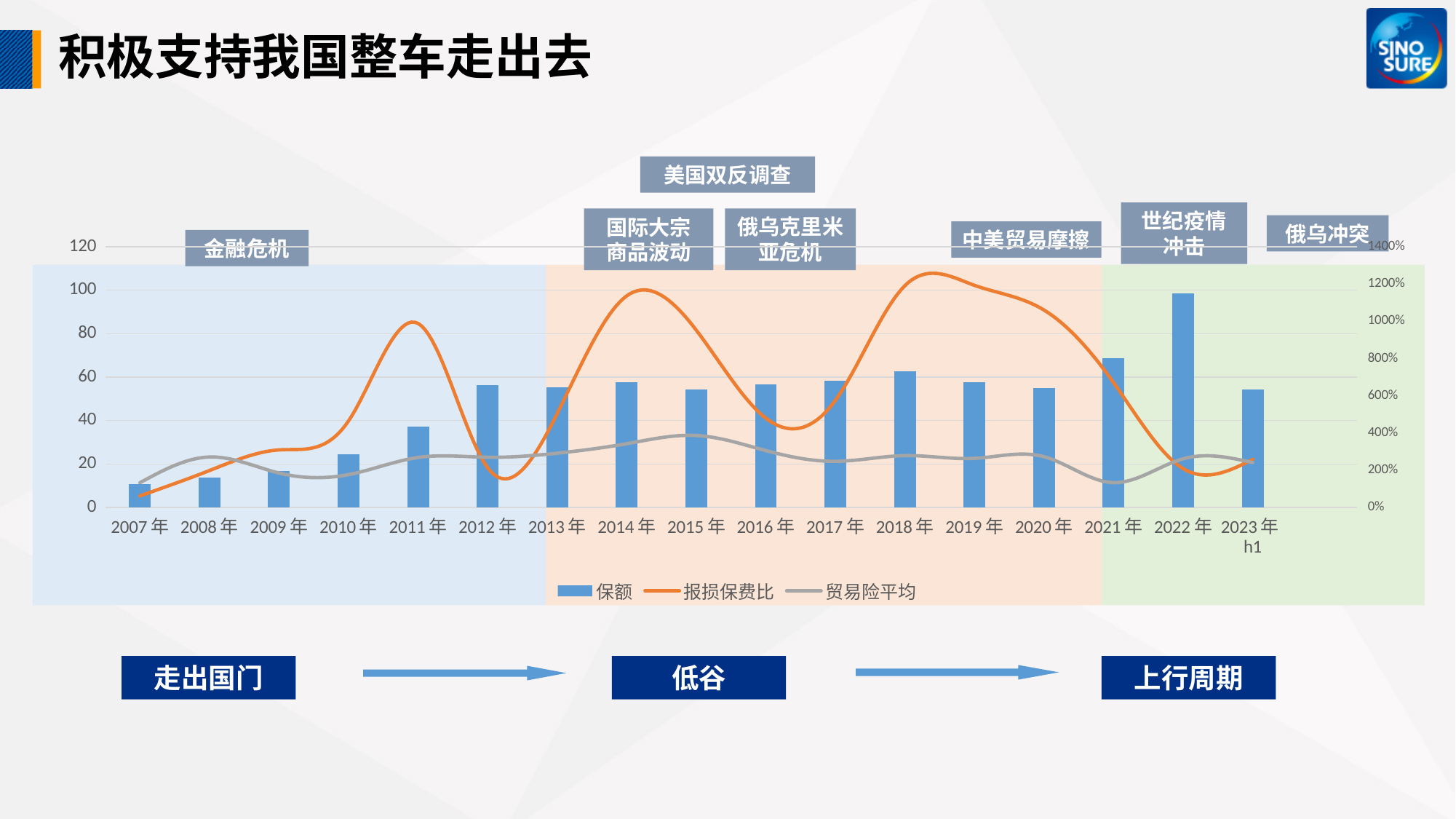
How many year categories are shown on the x axis of the chart? 17 What kind of chart is shown on the slide? A combined bar and line chart Is the 保额 value for 2022年 greater or less than 80? greater Do the 保额 bars rise or fall from 2007年 to 2012年? rise Is the 保额 value for 2007年 greater or less than 20? less Is the 报损保费比 value for 2014年 greater or less than 1000%? greater Which year has the larger 保额 bar, 2011年 or 2012年? 2012年 Which year has the highest 保额 bar? 2022年 What are the three series named in the chart legend? 保额, 报损保费比, 贸易险平均 How many series does the chart legend list? 3 Which year has the lowest 保额 bar? 2007年